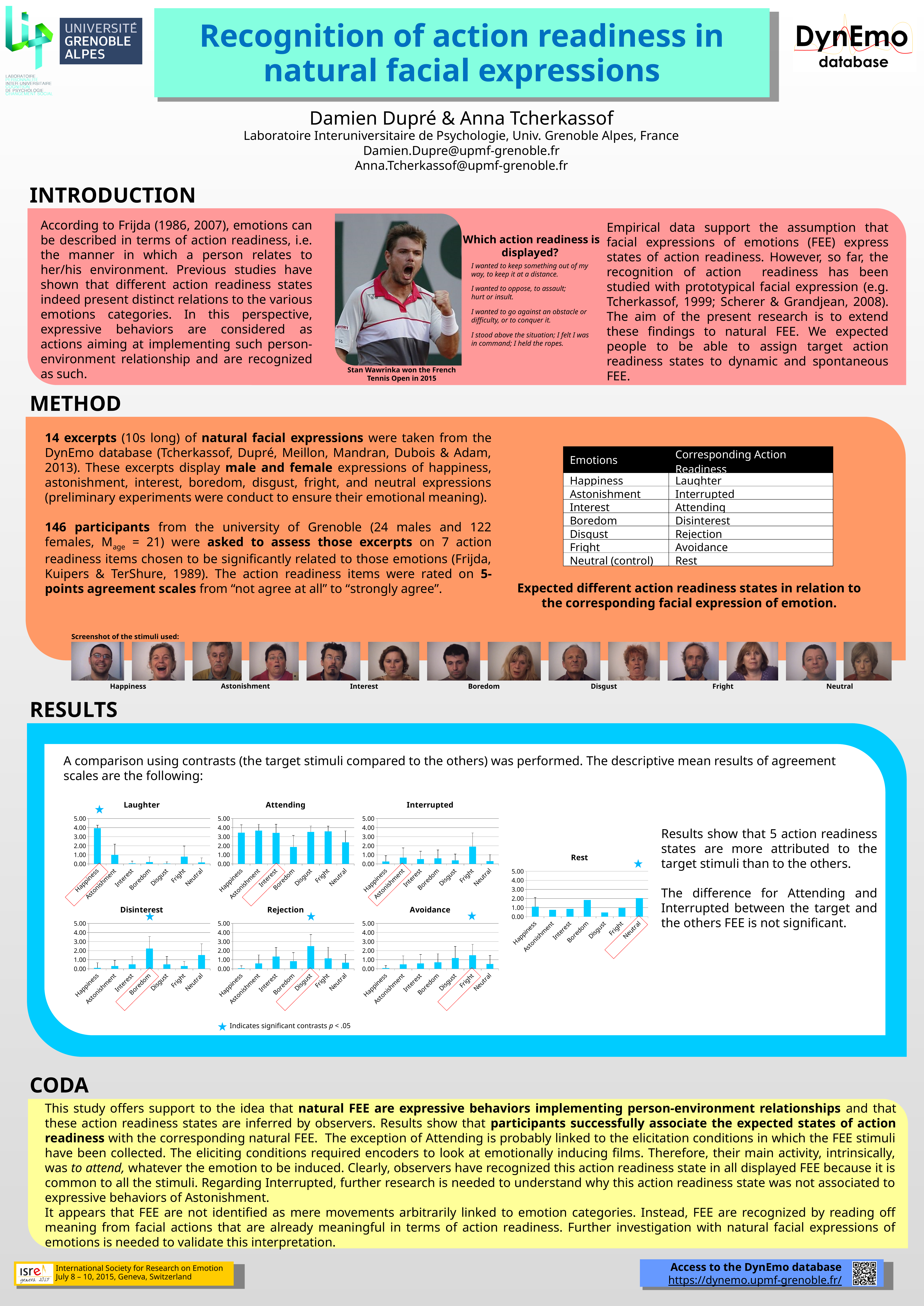
How many emotion categories are shown on the x axis of the Laughter chart? 7 How many bar charts are shown in the Results section? 7 In the Laughter chart, which is larger, the value for Happiness or the value for Astonishment? Happiness In the Interrupted chart, which emotion category has the highest bar? Fright In the Disinterest chart, which emotion category has the highest bar? Boredom In the Laughter chart, which emotion category has the highest bar? Happiness In the Attending chart, which emotion category has the lowest bar? Boredom In the Laughter chart, is the value for Happiness greater or less than 3.00? greater What kind of chart is the Laughter chart? bar chart In the Rest chart, is the value for Boredom greater or less than 1.00? greater In the Attending chart, is the value for Happiness greater or less than 3.00? greater